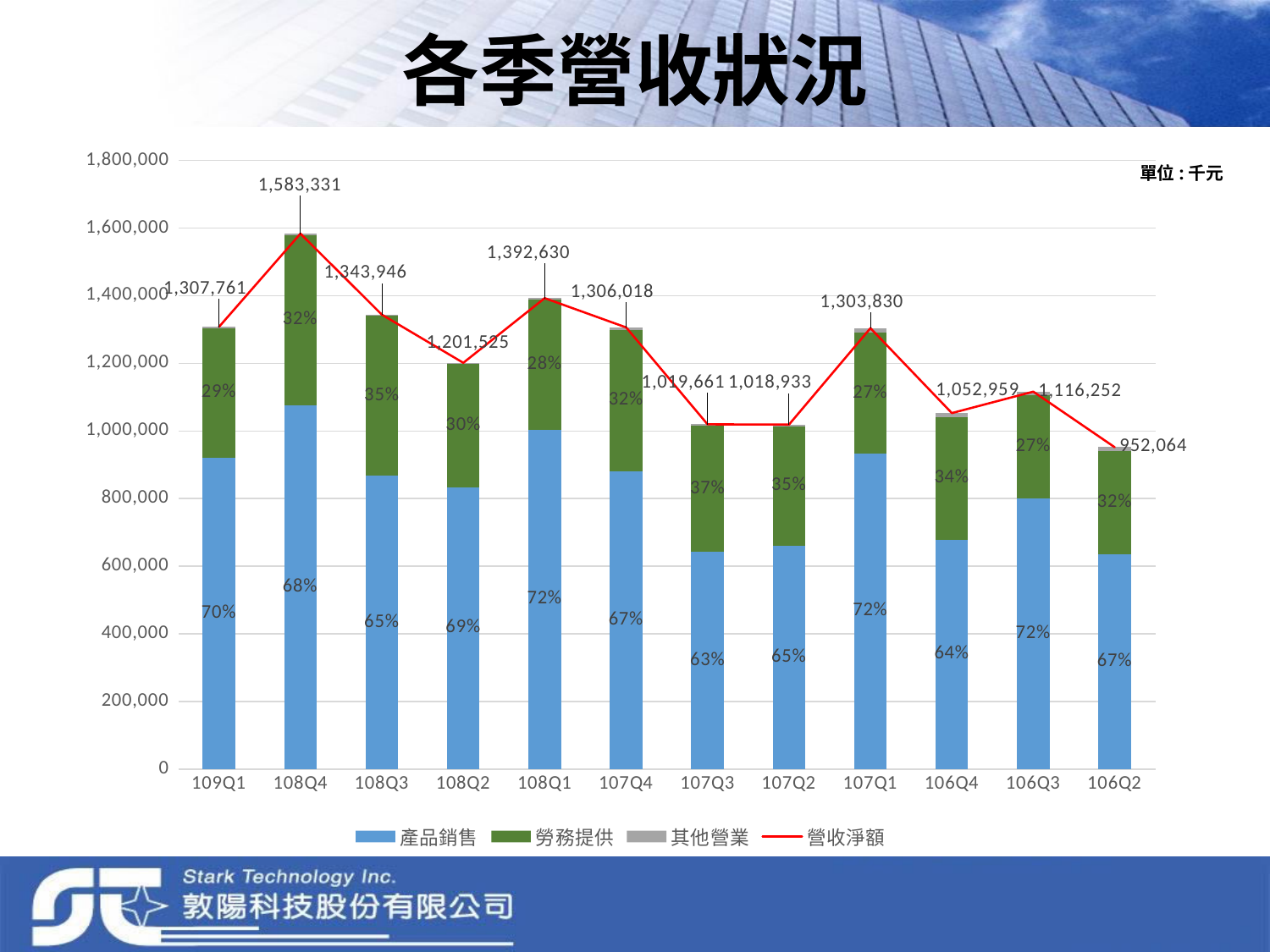
Which quarter has a larger 營收淨額, 108Q1 or 107Q4? 108Q1 What is the difference in 營收淨額 between 108Q4 and 106Q2? 631,267 Which quarter has the highest 營收淨額? 108Q4 Is the 產品銷售 value for 108Q4 greater or less than 1,000,000? greater What is the 營收淨額 value for 106Q2? 952,064 What percentage label is shown for 勞務提供 in 108Q3? 35% What percentage label is shown for 產品銷售 in 107Q3? 63% How many quarters are shown on the x axis? 12 Which quarter has the lowest 營收淨額? 106Q2 How many series does the legend list? 4 What unit is stated for the values in the chart? 千元 What is the 營收淨額 value for 108Q4? 1,583,331